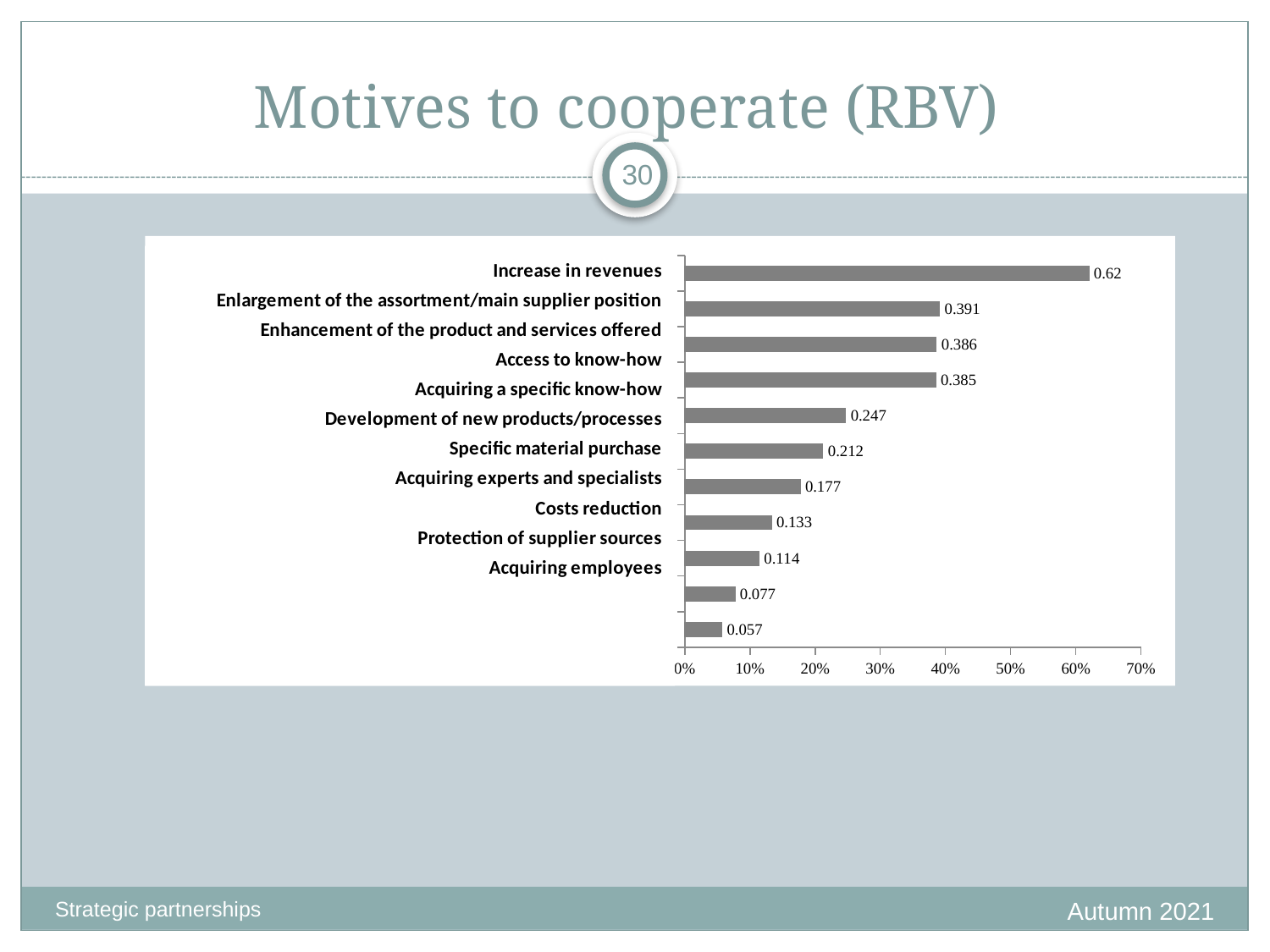
Which motive has the highest value in the chart? Increase in revenues Which is larger, the value for Increase in revenues or the value for Acquiring employees? Increase in revenues What kind of chart is shown on the slide? bar chart What is the maximum value shown on the horizontal axis of the chart? 70% Is the value for Increase in revenues greater or less than 50%? greater What is the title of the slide containing the chart? Motives to cooperate (RBV) How many motives (categories) are plotted in the chart? 11 Which motive has the lowest value in the chart? Acquiring employees What is the value shown for Increase in revenues? 0.62 What is the difference between the highest value (0.62) and the lowest value (0.057) in the chart? 0.563 What is the value of the shortest bar in the chart? 0.057 What is the value of the longest bar in the chart? 0.62